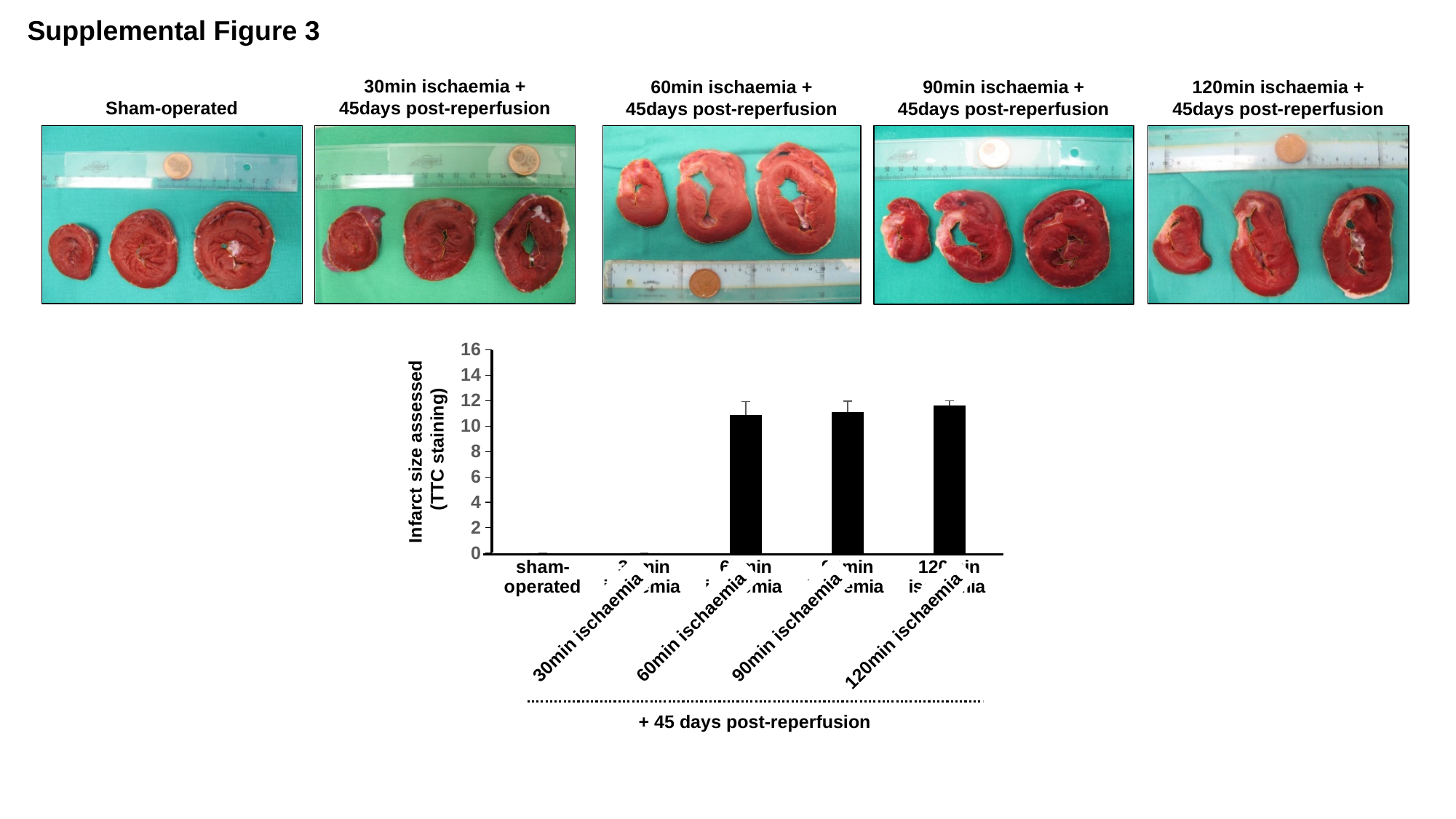
Is the value for 90min ischaemia greater or less than 14? less What is the maximum value shown on the y axis of the bar chart? 16 Is the value for 30min ischaemia greater or less than 2? less What kind of chart is shown on the slide? bar chart Is the value for 60min ischaemia greater or less than 8? greater Which has a larger infarct size, 30min ischaemia or 90min ischaemia? 90min ischaemia Do the bar values generally rise or fall from left to right along the x axis? rise How many categories are plotted on the x axis of the bar chart? 5 What annotation appears beneath the x-axis categories of the bar chart? + 45 days post-reperfusion What is the label of the y axis of the bar chart? Infarct size assessed (TTC staining) Which has a larger infarct size, sham-operated or 60min ischaemia? 60min ischaemia